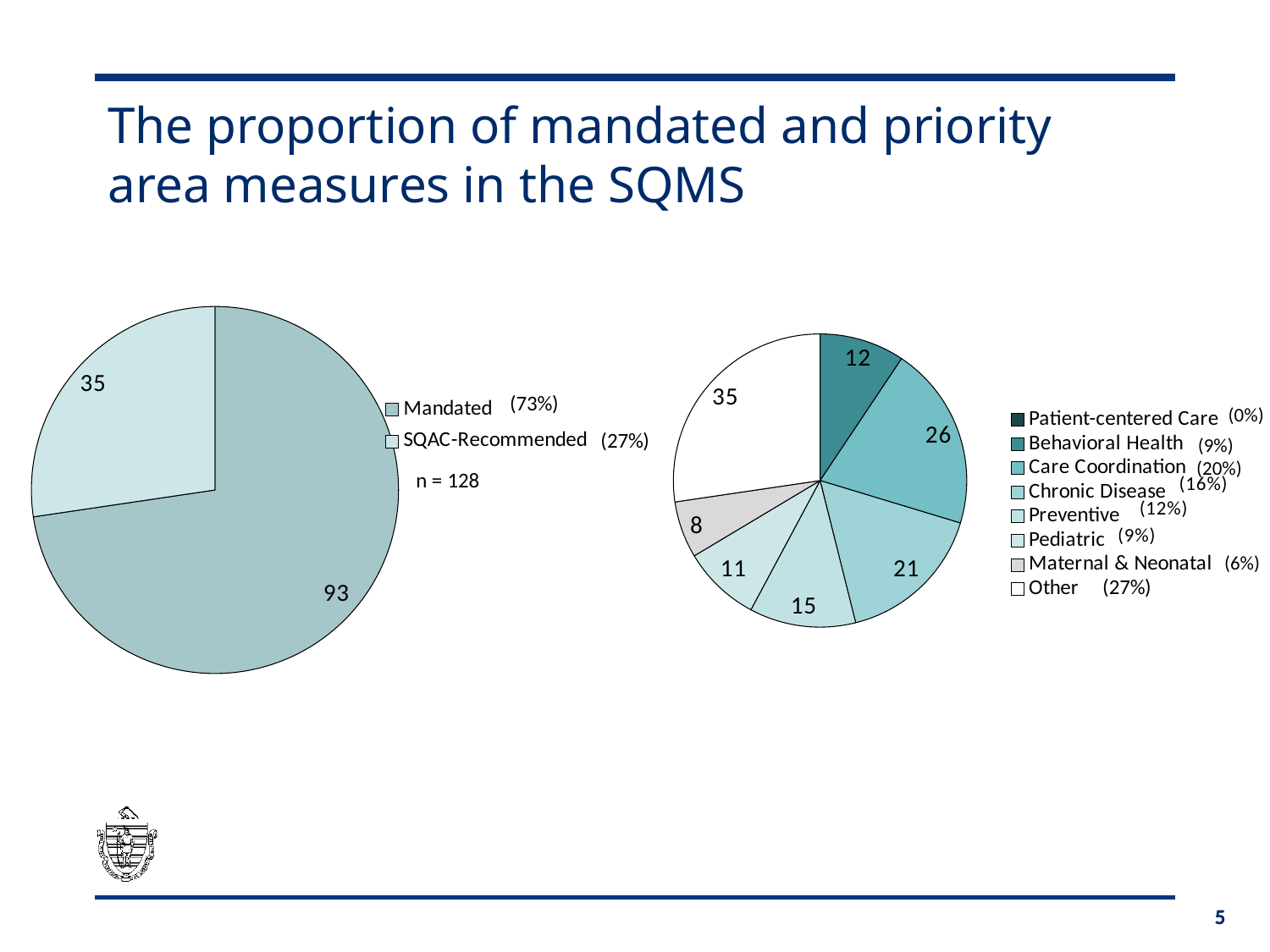
In the left pie chart, what share of the pie is Mandated? 73% In the left pie chart, what is the value for SQAC-Recommended? 35 In the right pie chart, which category has the largest slice? Other What type of chart is shown on the left of the slide? Pie chart In the left pie chart, what is the total n shown? n = 128 In the right pie chart, what is the value for Maternal & Neonatal? 8 In the left pie chart, what is the value for Mandated? 93 In the right pie chart, what share of the pie is Chronic Disease? 16% How many categories does the legend of the right pie chart list? 8 In the right pie chart, which is larger, Preventive or Pediatric? Preventive In the right pie chart, what is the value for Care Coordination? 26 In the left pie chart, what is the difference between the Mandated and SQAC-Recommended values? 58